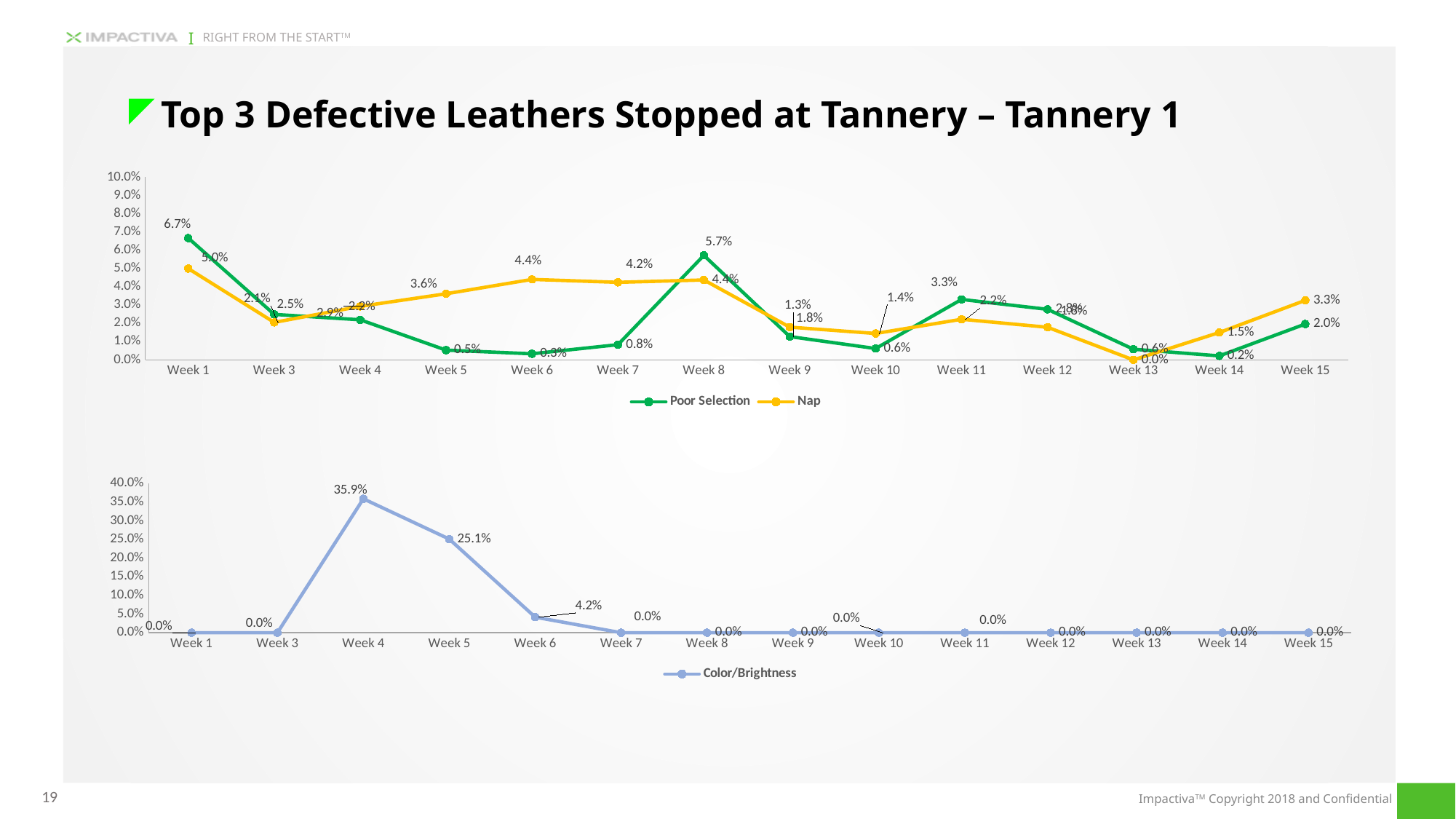
How many series does the legend of the top chart list? 2 What kind of chart is the bottom chart? Line chart In the bottom chart, what is the difference between the Color/Brightness values for Week 4 and Week 5? 10.8% In the top chart, which week has the lowest Nap value? Week 13 In the top chart, which week has the highest Poor Selection value? Week 1 In the bottom chart, what is the Color/Brightness value for Week 4? 35.9% In the top chart, what is the difference between the Nap and Poor Selection values in Week 5? 3.1% In the bottom chart, which week has the highest Color/Brightness value? Week 4 In the top chart, which series has the larger value in Week 11, Poor Selection or Nap? Poor Selection In the top chart, what is the Poor Selection value for Week 1? 6.7% In the top chart, what is the Nap value for Week 6? 4.4% In the top chart, what is the Poor Selection value for Week 8? 5.7%